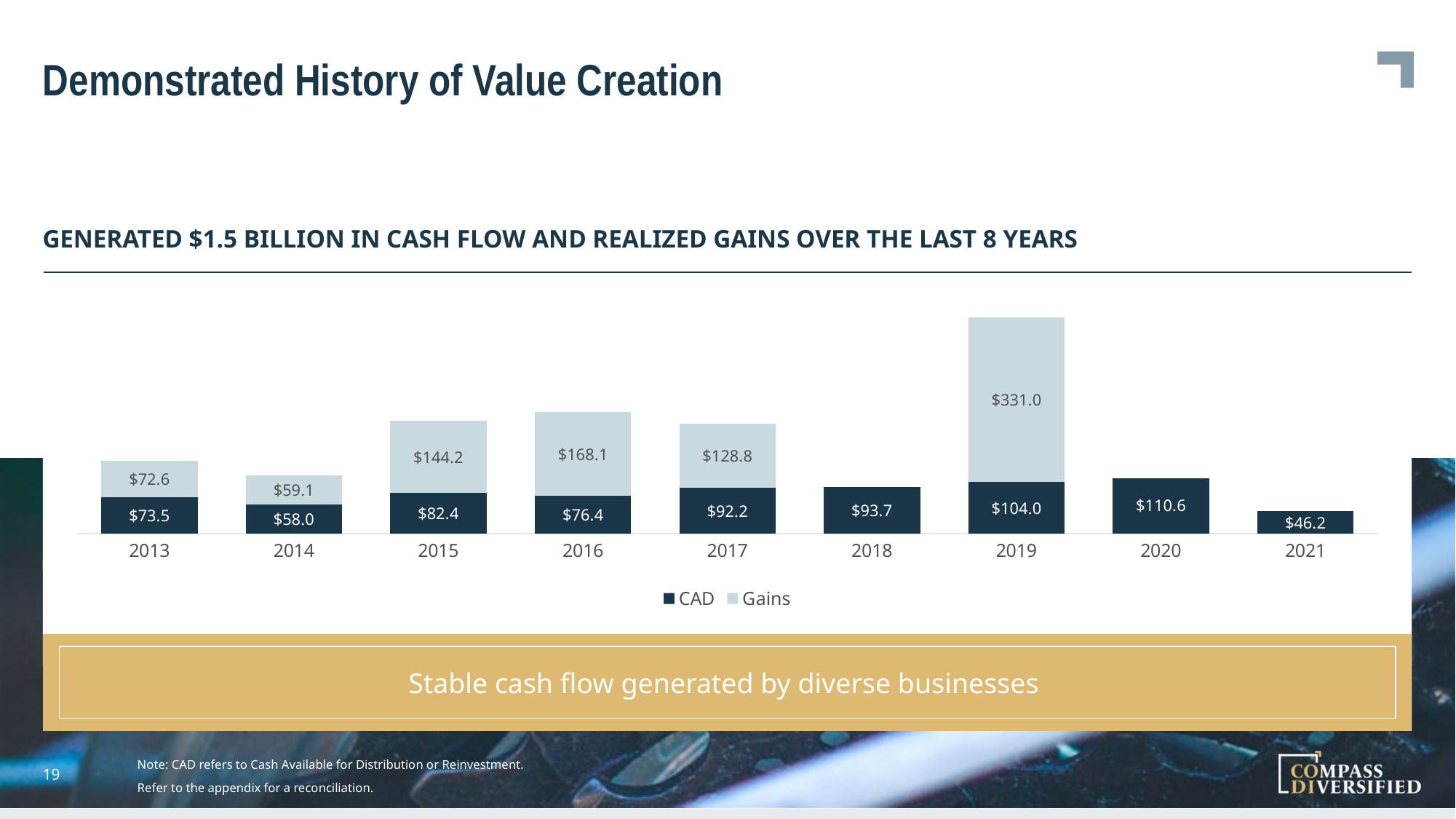
Which is larger, the Gains value for 2016 or the Gains value for 2017? 2016 What is the CAD value for 2014? $58.0 Which year has the lowest CAD value? 2021 Which year has the largest Gains value? 2019 How many years are shown on the x axis? 9 What kind of chart is shown on the slide? Stacked bar chart What is the Gains value for 2019? $331.0 What is the CAD value for 2020? $110.6 What is the total of the stacked bar for 2019 (CAD plus Gains)? $435.0 What is the difference between the CAD values for 2020 and 2021? $64.4 How many series does the legend list? 2 Which year has the highest CAD value? 2020